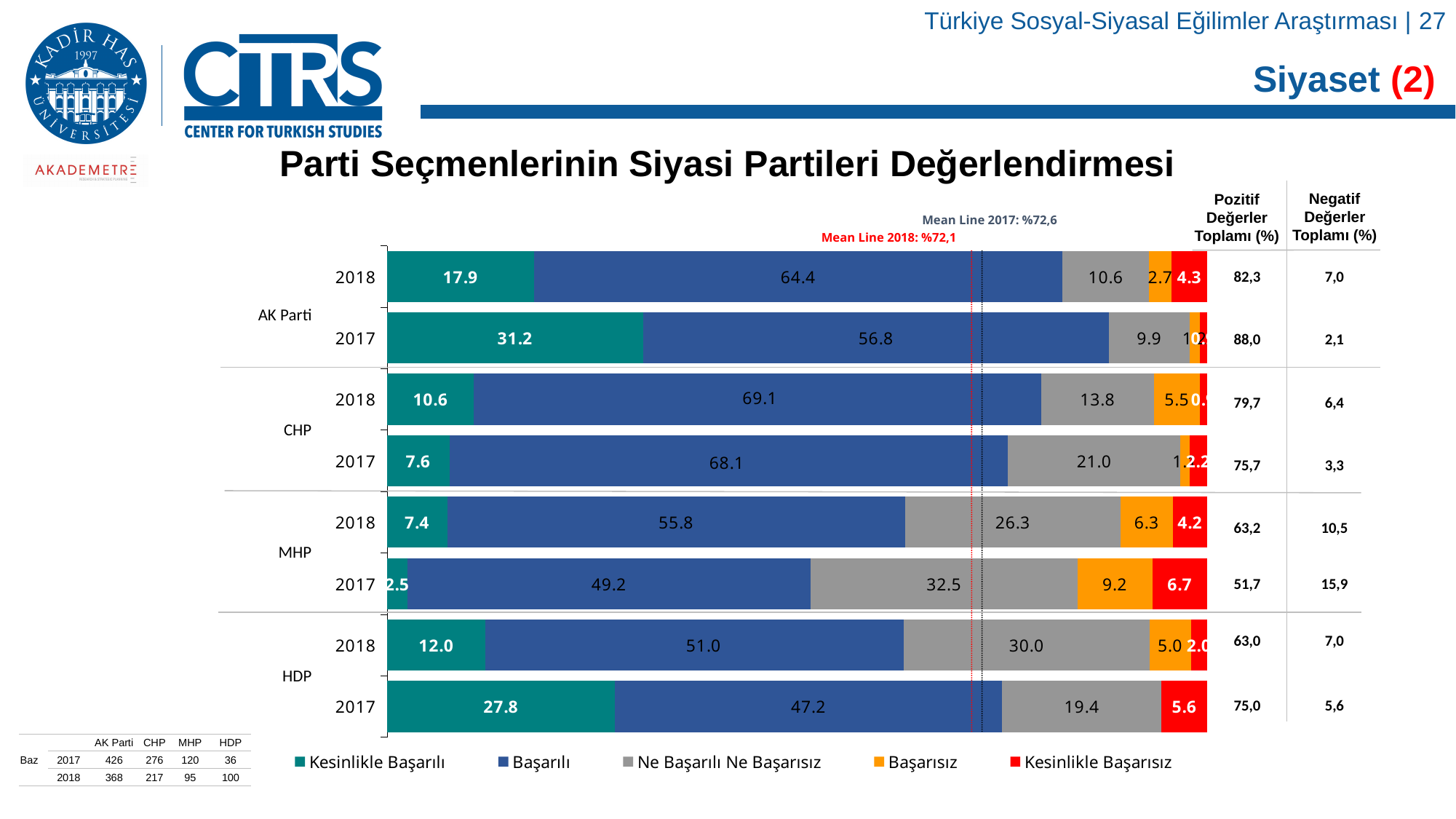
Which is larger, the Başarısız value for MHP 2018 or for HDP 2018? MHP 2018 Which bar has the lowest Kesinlikle Başarılı value? MHP 2017 What is the Ne Başarılı Ne Başarısız value for MHP in 2017? 32.5 What is the difference between the Kesinlikle Başarılı values for AK Parti in 2017 and 2018? 13.3 Which bar has the highest Başarılı value? CHP 2018 What is the Kesinlikle Başarılı value for HDP in 2017? 27.8 How many series does the legend list? 5 How many bars are plotted in the chart? 8 What kind of chart is shown on the slide? Stacked bar chart What is the Kesinlikle Başarılı value for AK Parti in 2018? 17.9 What is the Ne Başarılı Ne Başarısız value for CHP in 2018? 13.8 What is the Kesinlikle Başarısız value for MHP in 2017? 6.7